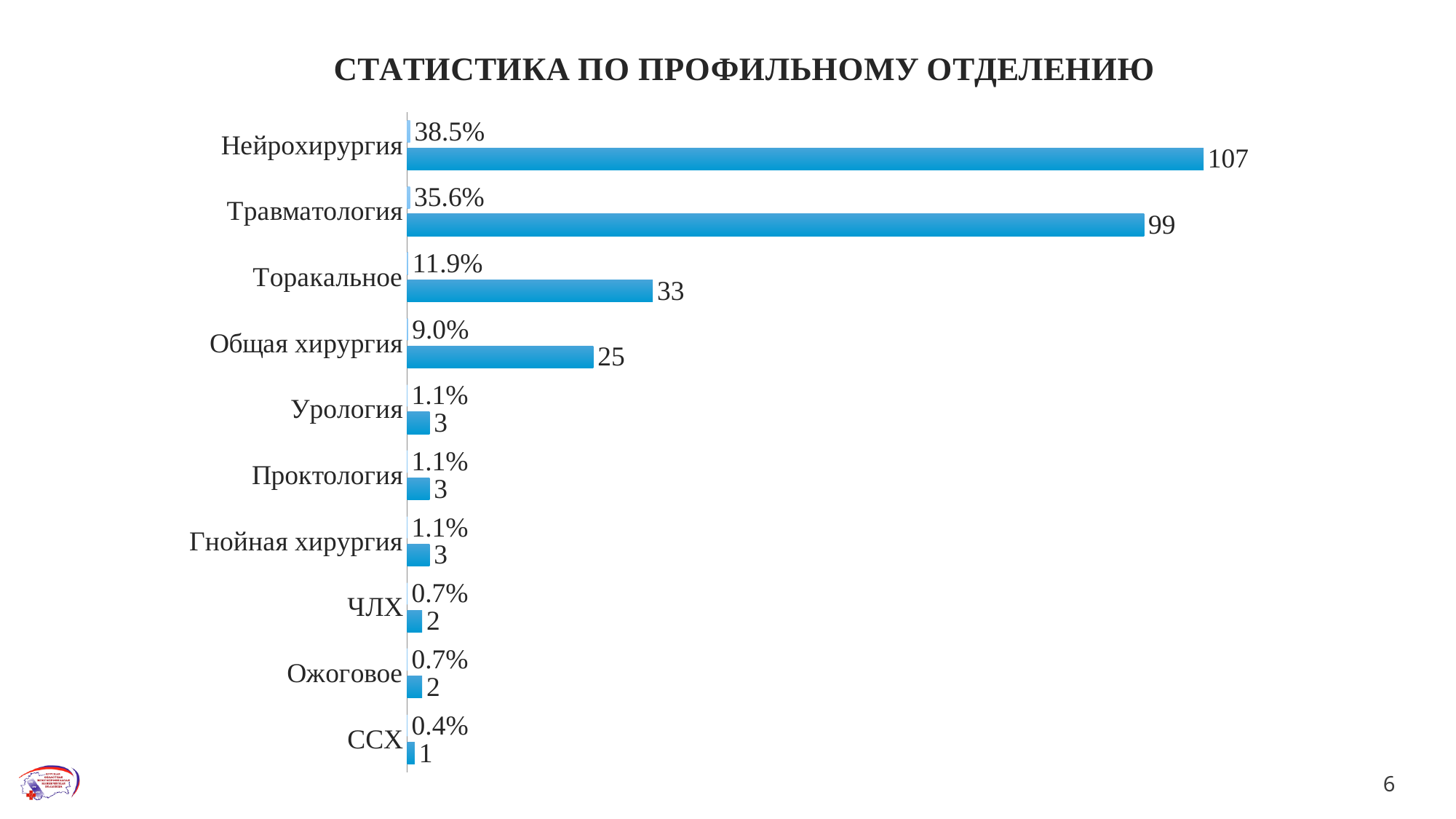
What is the count value for Ожоговое? 2 What kind of chart is shown on the slide? Bar chart Which has a larger count, Торакальное or Общая хирургия? Торакальное What percentage is shown for Травматология? 35.6% What is the difference between the counts for Нейрохирургия and Травматология? 8 Which department has the lowest count? ССХ What is the count value for Торакальное? 33 How many categories (departments) are shown in the chart? 10 What percentage is shown for Общая хирургия? 9.0% Which department has the highest count? Нейрохирургия What is the title of the chart? СТАТИСТИКА ПО ПРОФИЛЬНОМУ ОТДЕЛЕНИЮ What is the count value for Нейрохирургия? 107